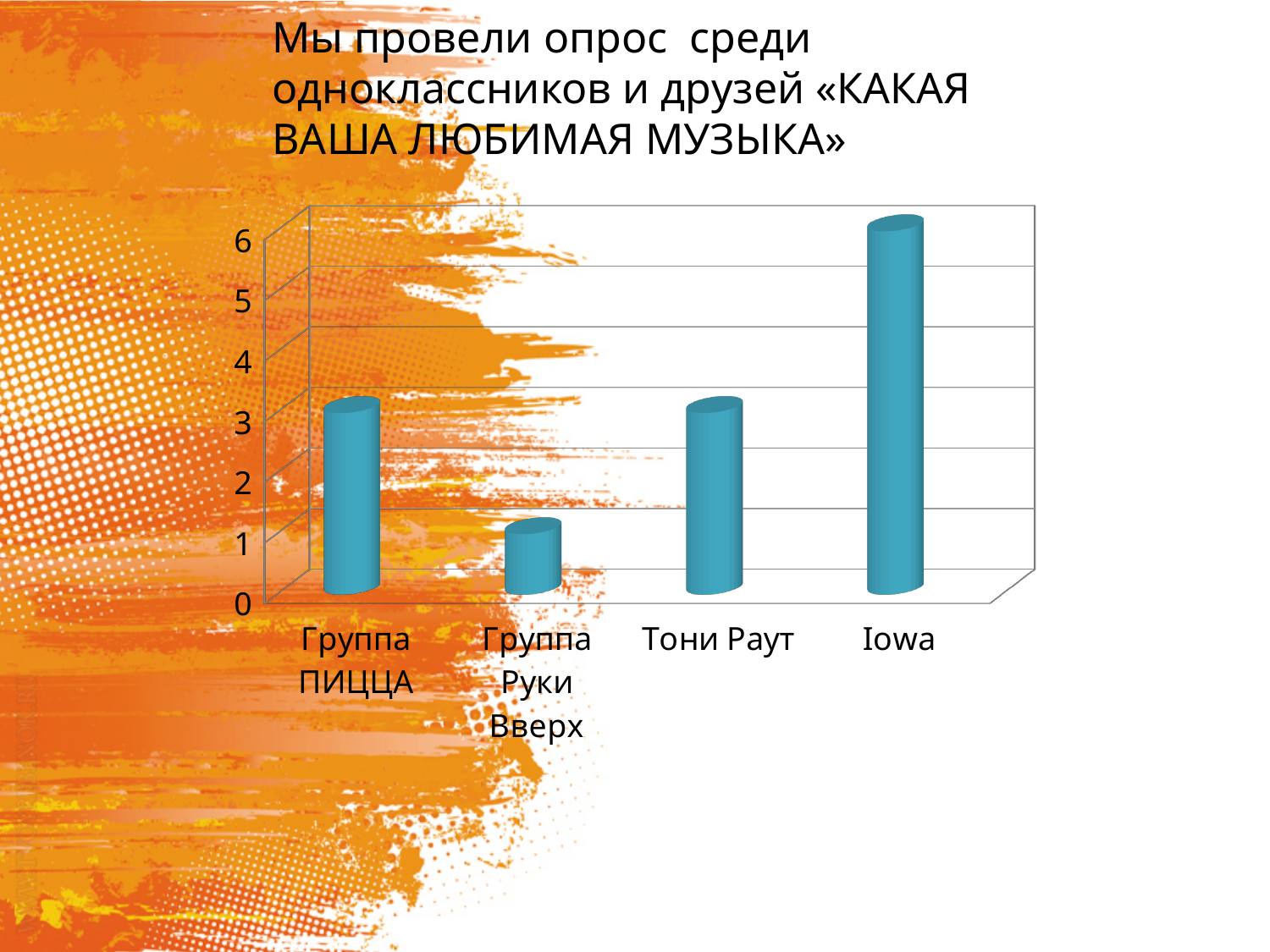
What is the value for Группа Руки Вверх? 1 What is the value for Iowa? 6 What is the difference between the value for Iowa and the value for Группа Руки Вверх? 5 What is the value for Тони Раут? 3 Is the value for Iowa greater or less than 5? greater What is the highest value shown on the vertical axis of the chart? 6 Is the value for Группа Руки Вверх greater or less than 2? less What kind of chart is shown on the slide? Bar chart Which is larger, the value for Iowa or the value for Тони Раут? Iowa How many categories are shown on the x axis of the chart? 4 Which category has the highest bar in the chart? Iowa Which category has the lowest bar in the chart? Группа Руки Вверх